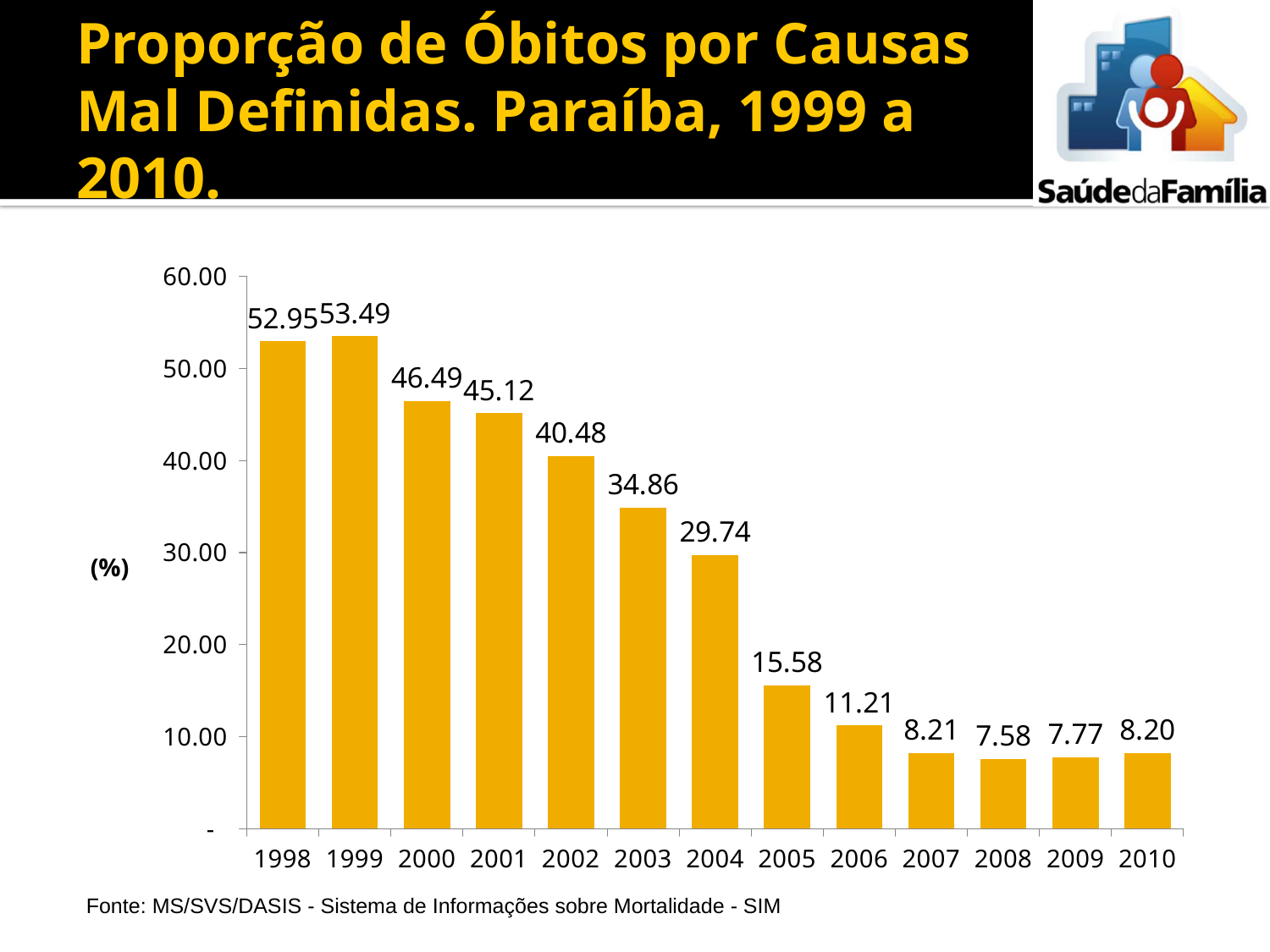
What kind of chart is shown on the slide? bar chart Do the values generally rise or fall from 1998 to 2010? fall Is the value for 2003 greater or less than 30.00? greater Which year has the lowest value? 2008 What is the value for 2002? 40.48 How many years are shown on the x axis? 13 Which year has the highest value? 1999 What is the difference between the values for 2004 and 2005? 14.16 What is the value for 2010? 8.20 What is the value for 2005? 15.58 What is the difference between the values for 1998 and 2010? 44.75 Which is larger, the value for 2005 or the value for 2006? 2005